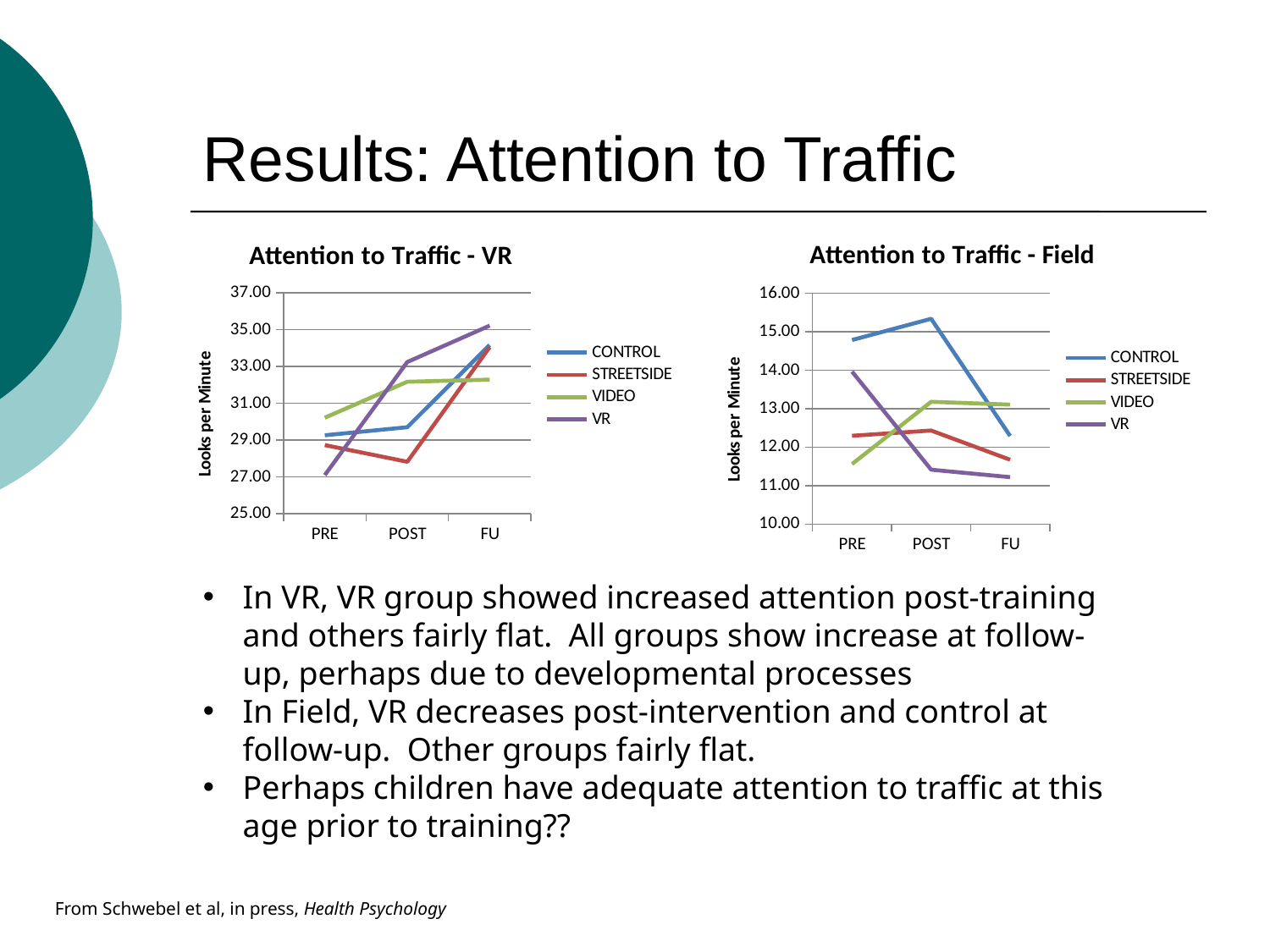
How many series does the legend of the "Attention to Traffic - VR" chart list? 4 In the "Attention to Traffic - Field" chart, is the CONTROL group's value at POST greater or less than 14.00? greater What is the y-axis label on the "Attention to Traffic - Field" chart? Looks per Minute In the "Attention to Traffic - VR" chart, is the VR group's value at FU greater or less than 33.00? greater In the "Attention to Traffic - VR" chart, which group has the lowest value at PRE? VR In the "Attention to Traffic - VR" chart, which group has the highest value at FU? VR In the "Attention to Traffic - Field" chart, which group has the highest value at POST? CONTROL How many time points are shown on the x axis of the "Attention to Traffic - Field" chart? 3 In the "Attention to Traffic - Field" chart, does the VR group's line rise or fall from PRE to FU? fall In the "Attention to Traffic - VR" chart, does the VR group's line rise or fall from PRE to FU? rise In the "Attention to Traffic - VR" chart, is the VR group's value at PRE greater or less than 29.00? less What type of chart is the "Attention to Traffic - VR" chart? line chart